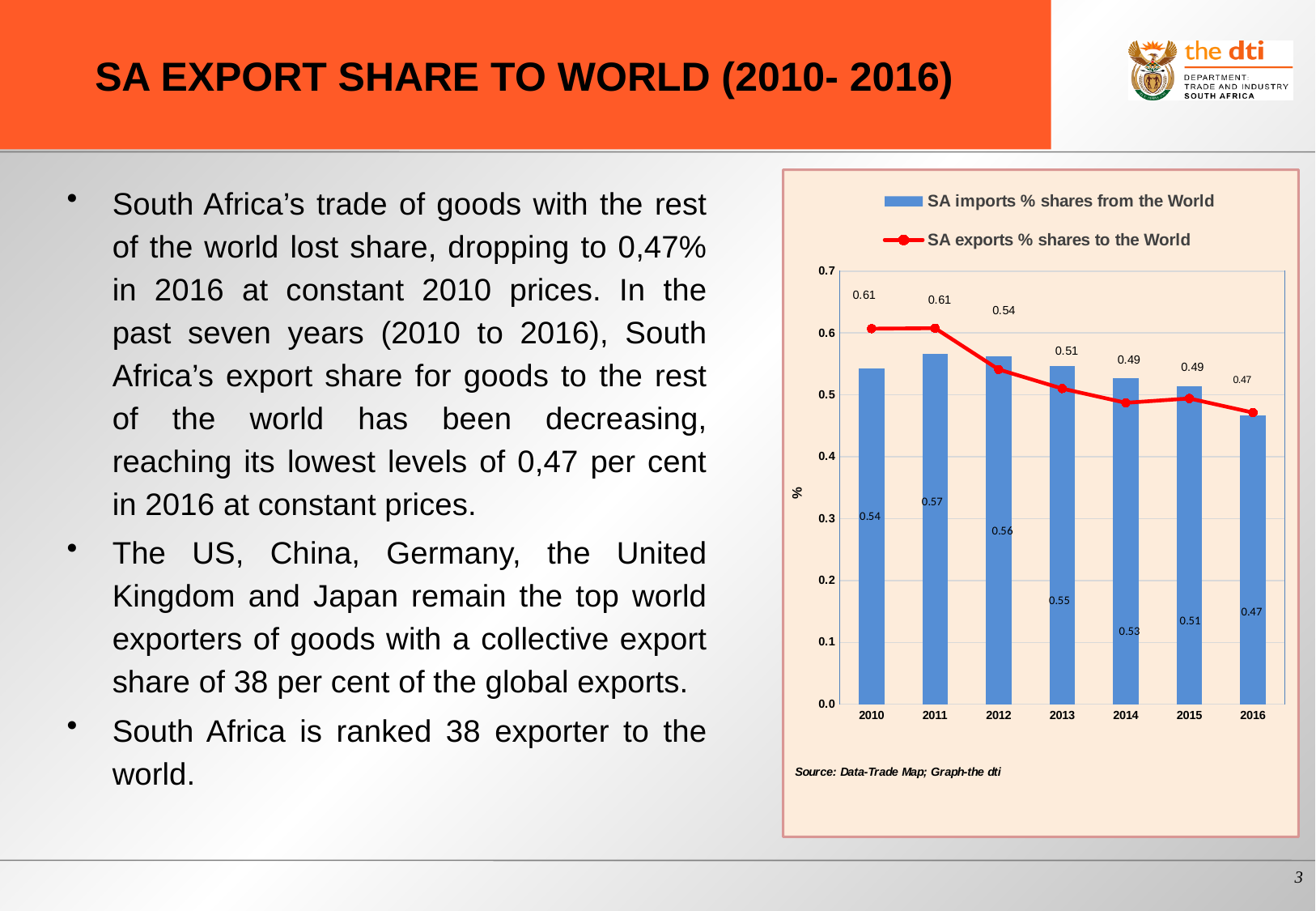
In which year is SA exports % shares to the World lowest? 2016 What kind of chart is shown on the slide? Combined bar and line chart What is the value of SA imports % shares from the World in 2016? 0.47 Which is larger in 2012: SA imports % shares from the World or SA exports % shares to the World? SA imports % shares from the World Which series is drawn as a red line with markers? SA exports % shares to the World How many series does the legend list? 2 How many years are shown on the x axis? 7 What is the value of SA imports % shares from the World in 2011? 0.57 What is the difference between SA exports % shares to the World in 2010 and in 2016? 0.14 What is the value of SA exports % shares to the World in 2013? 0.51 Does SA exports % shares to the World rise or fall from 2010 to 2016? Fall In which year is SA imports % shares from the World highest? 2011